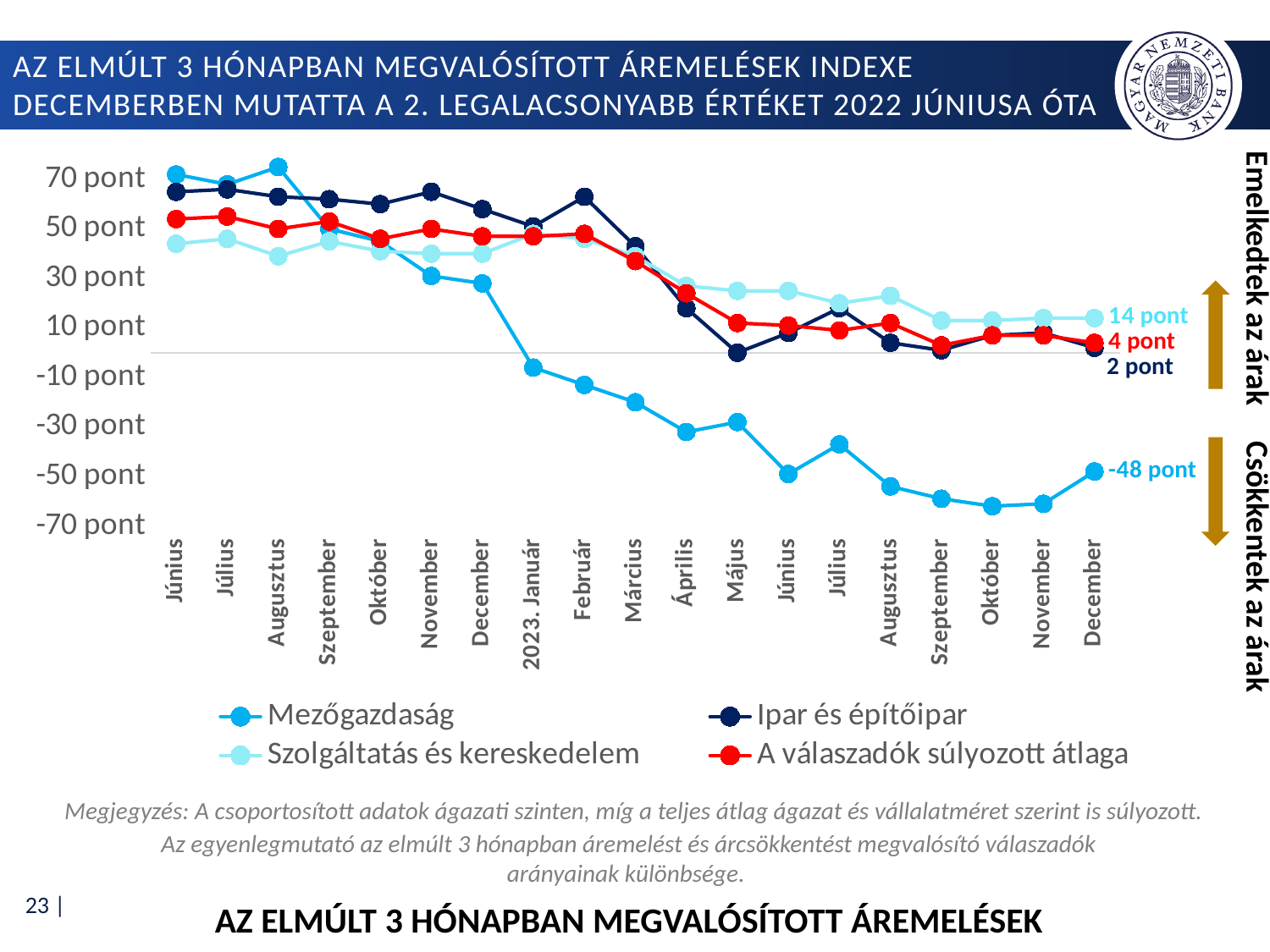
What is the value for Ipar és építőipar in December (the last point)? 2 pont What is the value for A válaszadók súlyozott átlaga in December (the last point)? 4 pont Which series has the lowest value in December (the last point)? Mezőgazdaság Is the value for Mezőgazdaság in 2023. Január greater or less than 10 pont? less How many months are shown on the x axis? 19 What is the value for Szolgáltatás és kereskedelem in December (the last point)? 14 pont How many series does the legend list? 4 What type of chart is shown on the slide? line chart Which series has the highest value in December (the last point)? Szolgáltatás és kereskedelem What is the difference between the December values of Szolgáltatás és kereskedelem (14 pont) and Ipar és építőipar (2 pont)? 12 pont Does the Mezőgazdaság series generally rise or fall from the first Június to the last December? fall What is the value for Mezőgazdaság in December (the last point)? -48 pont